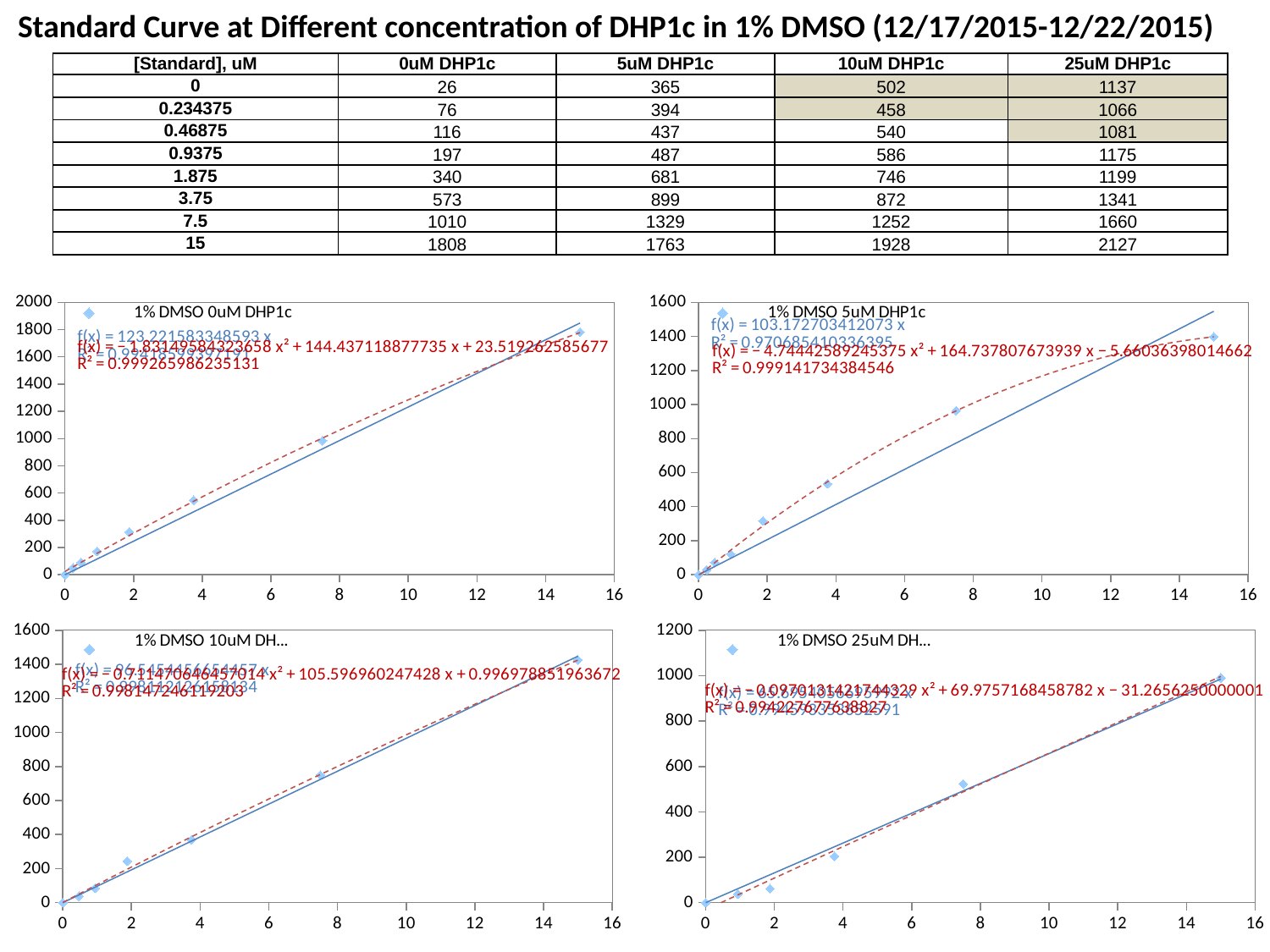
In the top-right chart (1% DMSO 5uM DHP1c), which plotted point is higher: the one at x = 15 or the one at x = 7.5? x = 15 What is the legend entry shown in the top-left chart? 1% DMSO 0uM DHP1c How many charts are shown on the slide? 4 What is the highest value shown on the y axis of the top-left chart (1% DMSO 0uM DHP1c)? 2000 In the top-right chart (1% DMSO 5uM DHP1c), is the plotted value at x = 15 greater or less than 1200? greater In the bottom-right chart (1% DMSO 25uM DH...), is the plotted value at x = 3.75 greater or less than 400? less What kind of chart is the top-left chart titled 1% DMSO 0uM DHP1c? scatter chart Which chart has the higher plotted value at x = 15: the top-right chart (1% DMSO 5uM DHP1c) or the bottom-right chart (1% DMSO 25uM DH...)? top-right chart (1% DMSO 5uM DHP1c) In the top-left chart (1% DMSO 0uM DHP1c), do the plotted values rise or fall as x increases? rise In the bottom-left chart (1% DMSO 10uM DH...), is the plotted value at x = 7.5 greater or less than 600? greater